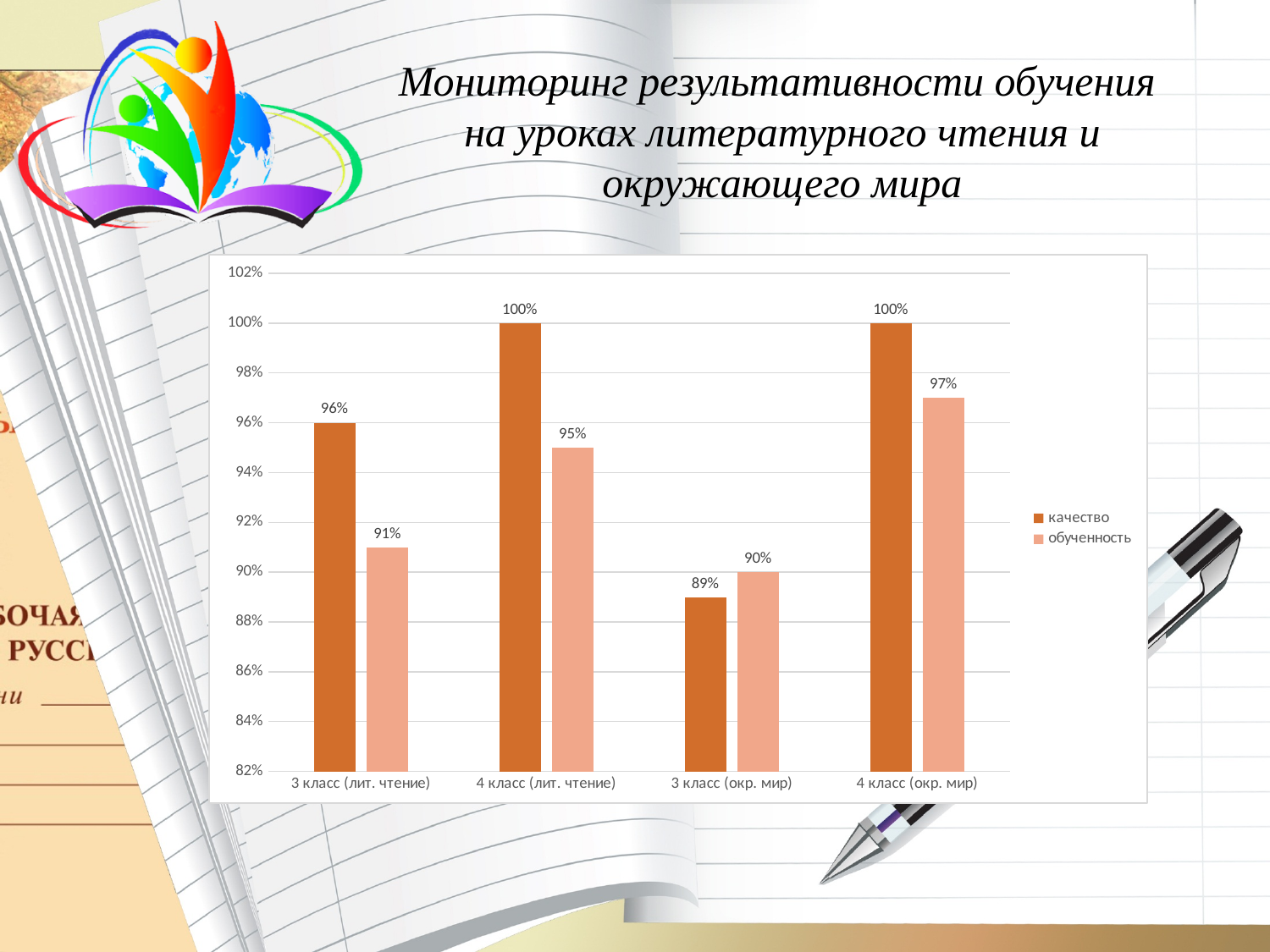
What is the value of обученность for 4 класс (лит. чтение)? 95% Which category has the highest обученность value? 4 класс (окр. мир) Which is larger for 3 класс (окр. мир): качество or обученность? обученность What is the value of качество for 3 класс (лит. чтение)? 96% What are the two series named in the legend? качество and обученность How many series does the legend list? 2 What is the difference between качество and обученность for 3 класс (лит. чтение)? 5% How many categories are shown on the x axis? 4 What kind of chart is shown on the slide? bar chart What is the value of обученность for 3 класс (окр. мир)? 90% Which category has the lowest качество value? 3 класс (окр. мир) What is the value of обученность for 4 класс (окр. мир)? 97%